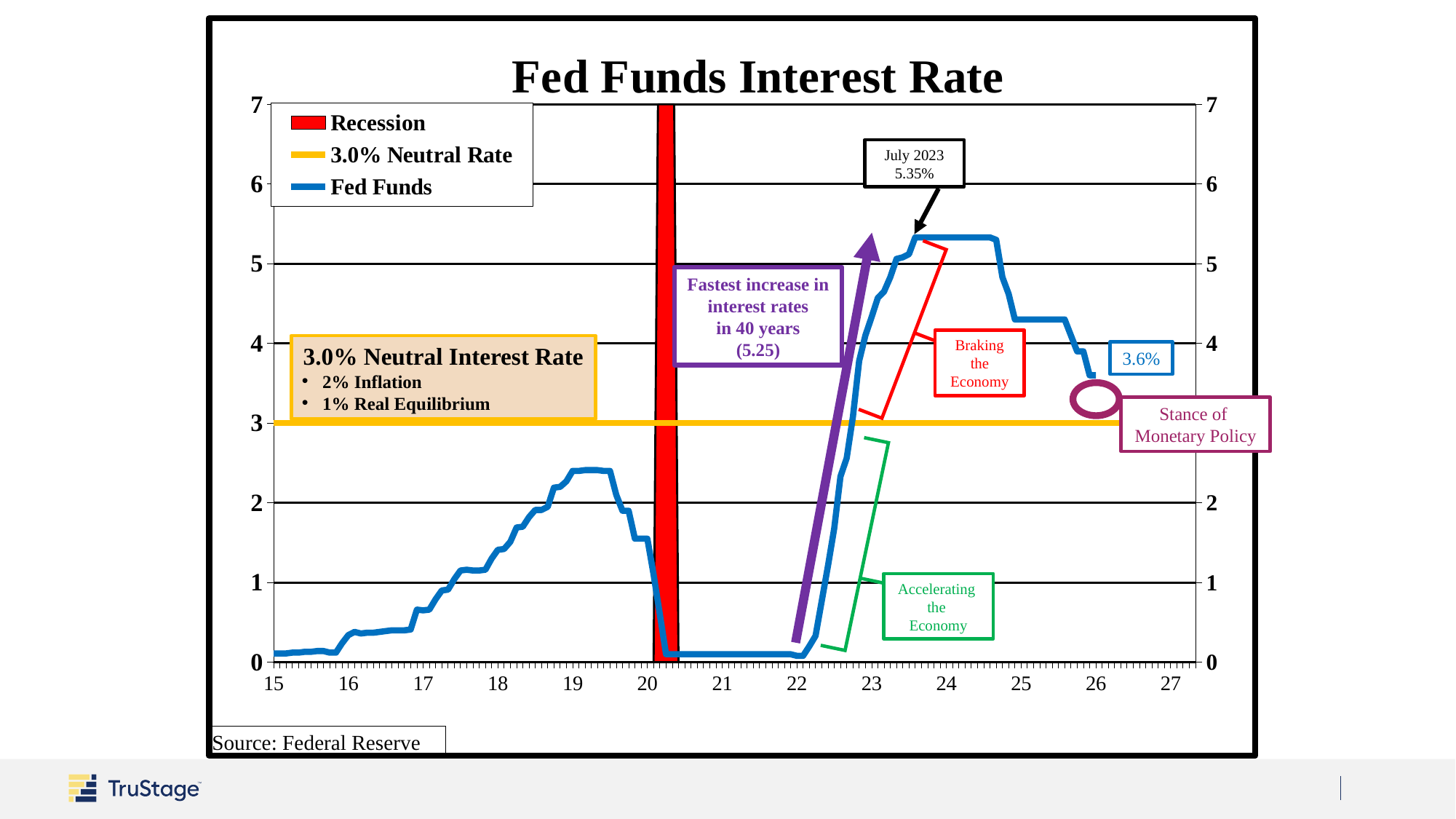
Does the Fed Funds line rise or fall between 2022 and 2023? rise What is the title of the chart? Fed Funds Interest Rate What source is cited for the chart? Federal Reserve What type of chart is shown on the slide? line chart Is the Fed Funds rate at the start of 2024 greater or less than 5? greater What Fed Funds rate is labeled at the end of the line near 2026? 3.6% Which is larger, the Fed Funds rate in July 2023 or the labeled rate near 2026? July 2023 What is the neutral interest rate shown by the yellow line? 3.0% How many series does the legend list? 3 What Fed Funds rate is labeled for July 2023? 5.35% Is the Fed Funds rate during 2021 greater or less than 1? less What is the difference between the July 2023 rate (5.35%) and the labeled 3.6% rate near 2026? 1.75%